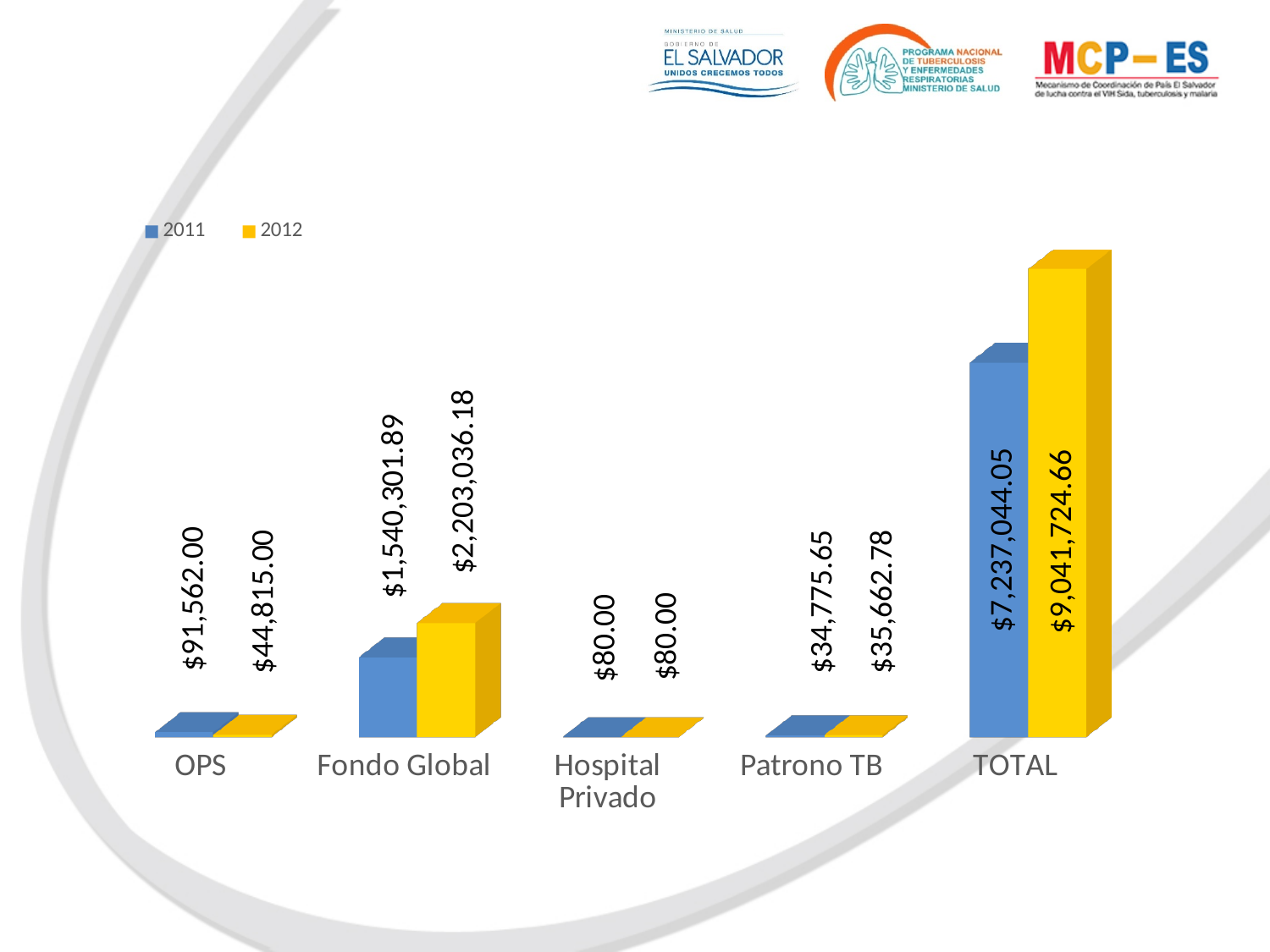
What is the difference between the 2011 and 2012 values for OPS? $46,747.00 What is the TOTAL value for 2011? $7,237,044.05 What is the difference between the 2012 and 2011 values for Fondo Global? $662,734.29 Which is larger for OPS: the 2011 value or the 2012 value? 2011 What kind of chart is shown on the slide? Bar chart What is the value for Patrono TB in 2012? $35,662.78 What is the value for Hospital Privado in 2012? $80.00 Excluding TOTAL, which category has the highest value in 2012? Fondo Global What is the value for OPS in 2011? $91,562.00 Excluding TOTAL, which category has the lowest value in 2011? Hospital Privado How many series does the legend list? 2 What is the value for Fondo Global in 2012? $2,203,036.18